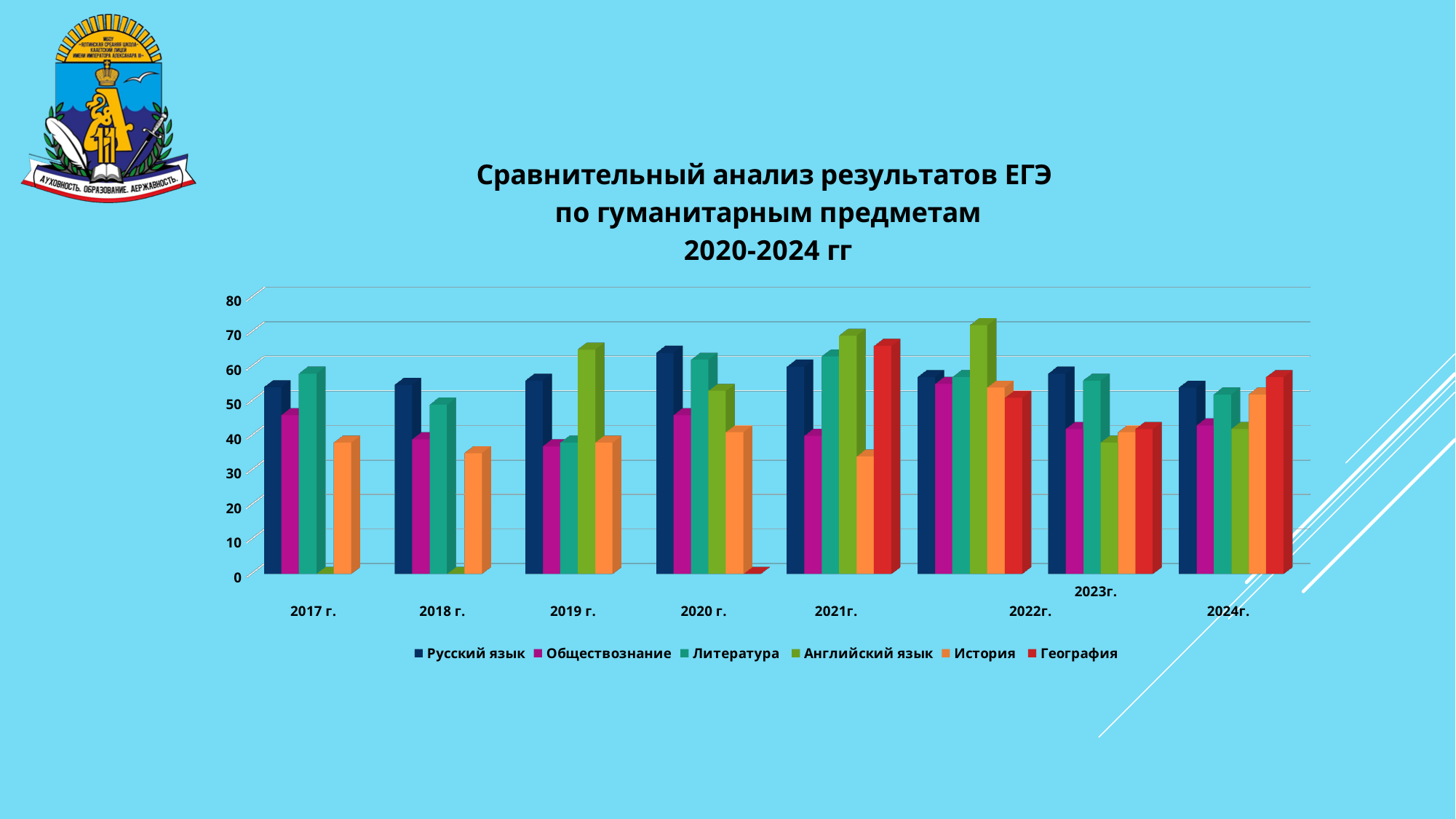
Is the value for Английский язык in 2022г. greater or less than 60? greater In 2019 г., which is larger: Английский язык or Обществознание? Английский язык Is the value for Обществознание in 2018 г. greater or less than 50? less How many year categories are shown on the x axis? 8 Which subject has the lowest value in 2021г.? История Is the value for История in 2021г. greater or less than 40? less What kind of chart is shown on the slide? bar chart How many series does the legend list? 6 In 2017 г., which is larger: Литература or Обществознание? Литература Which subject has the highest value in 2022г.? Английский язык Which subject is listed first in the legend? Русский язык